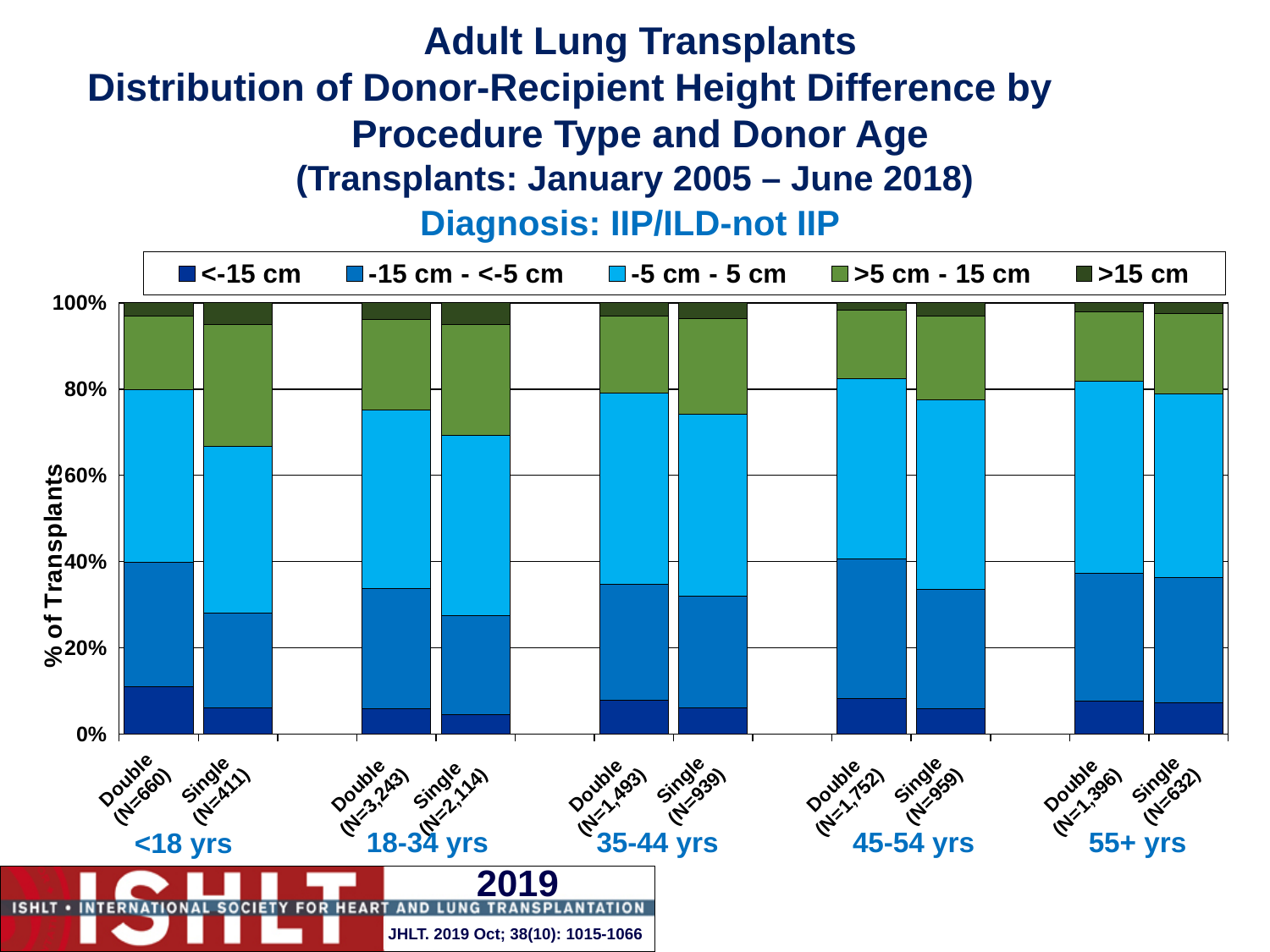
Which bar has the largest '<-15 cm' segment? Double (N=660), <18 yrs Is the '<-15 cm' segment for Double in the <18 yrs group greater or less than 20%? less How many donor age groups are shown along the x axis? 5 What is the total height of the Double (N=660) bar in the <18 yrs group? 100% How many bars are plotted in the chart? 10 How many series does the legend list? 5 Is the '-5 cm - 5 cm' segment for Double in the 55+ yrs group greater or less than 40%? greater What diagnosis group does the chart cover, according to the subtitle? IIP/ILD-not IIP In the <18 yrs group, which procedure type has the larger '<-15 cm' segment, Double or Single? Double Is the '>5 cm - 15 cm' segment for Single in the 18-34 yrs group greater or less than 20%? greater What kind of chart is shown on the slide? stacked bar chart What is the label of the y axis? % of Transplants